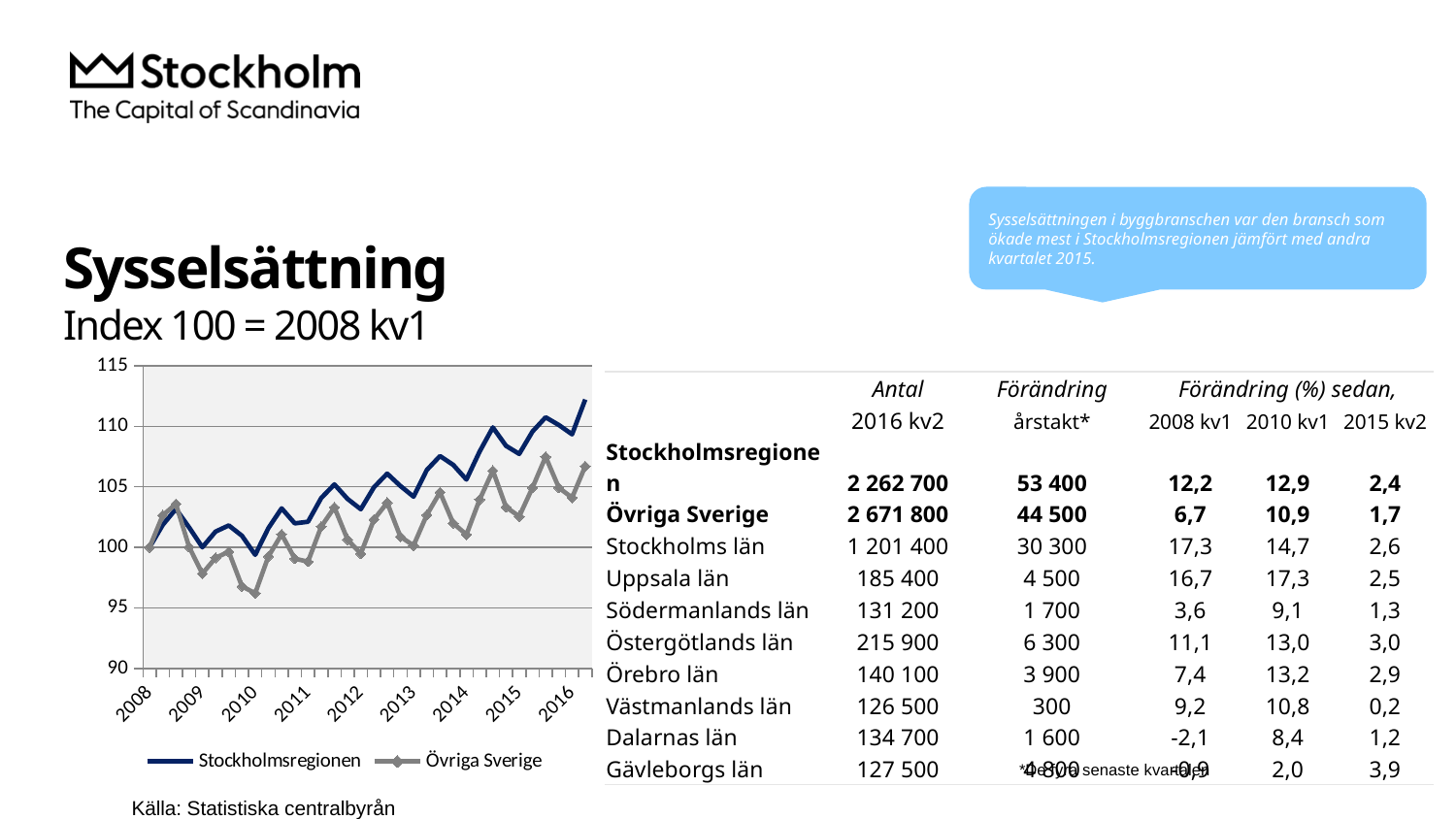
Is the value for Övriga Sverige at the end of 2016 greater or less than 105? greater Is the value for Stockholmsregionen at the end of 2016 greater or less than 110? greater Is the value for Övriga Sverige at the end of 2016 greater or less than 110? less How many year labels are shown on the chart's x axis? 9 Over the whole period from 2008 to 2016, does the Stockholmsregionen line overall rise or fall? rise What are the two series named in the chart's legend? Stockholmsregionen and Övriga Sverige Which series has the lower value around 2010, Stockholmsregionen or Övriga Sverige? Övriga Sverige How many series does the chart's legend list? 2 What kind of chart is shown on the slide? line chart What is the title of the chart? Sysselsättning At the end of 2016, which series has the higher value, Stockholmsregionen or Övriga Sverige? Stockholmsregionen